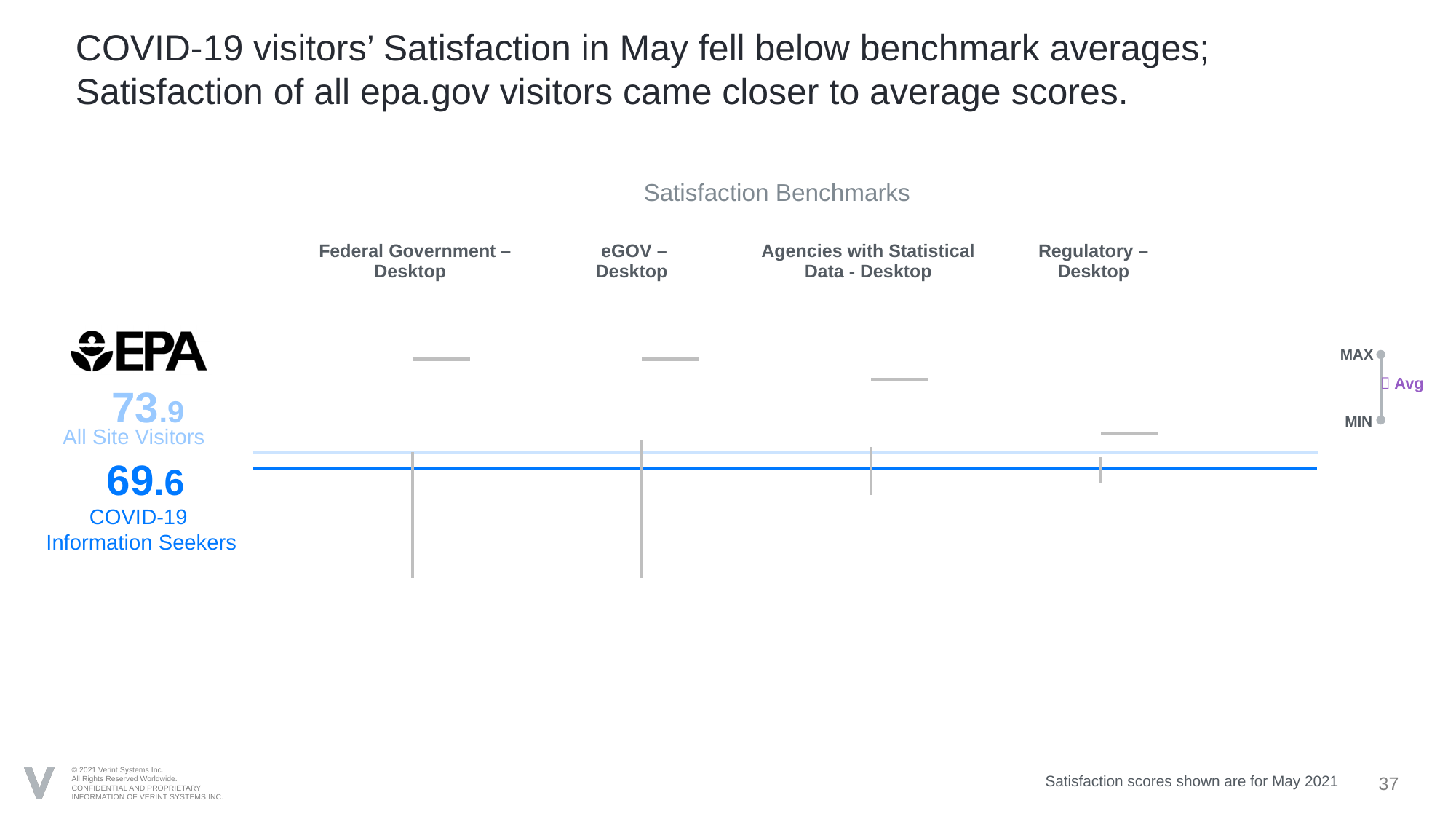
What is the difference between the All Site Visitors score and the COVID-19 Information Seekers score? 4.3 For which month are the satisfaction scores on the slide shown? May 2021 What is the satisfaction score shown for COVID-19 Information Seekers? 69.6 Which group has the higher satisfaction score, All Site Visitors or COVID-19 Information Seekers? All Site Visitors Is the COVID-19 Information Seekers score above or below the eGOV – Desktop benchmark average? below Is the COVID-19 Information Seekers score above or below the Federal Government – Desktop benchmark average? below What is the title of the chart? Satisfaction Benchmarks What is the satisfaction score shown for All Site Visitors? 73.9 How many benchmark categories are shown in the Satisfaction Benchmarks chart? 4 Which benchmark category has the lowest average satisfaction marker? Regulatory – Desktop